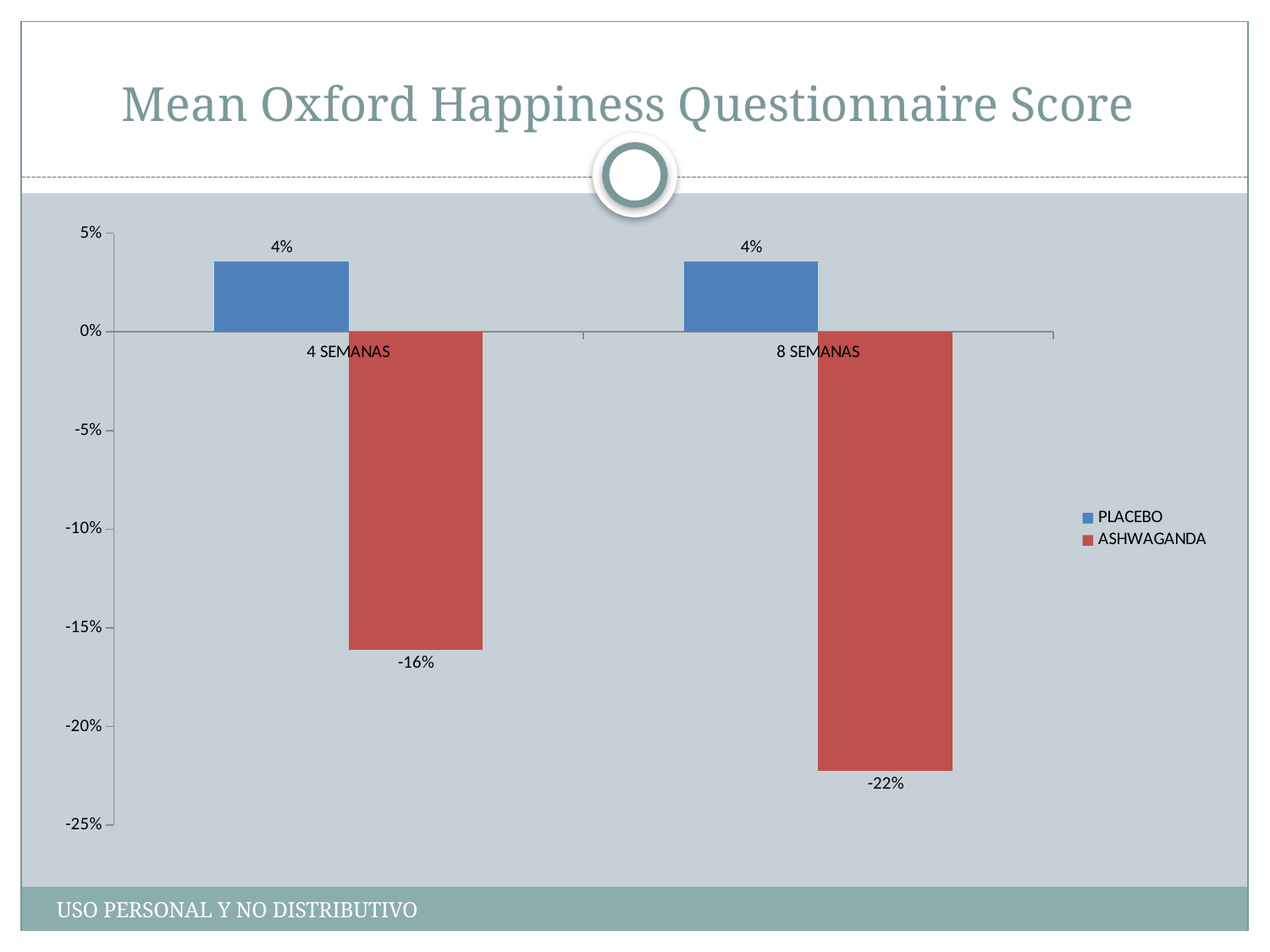
How many categories are shown on the x axis? 2 How many series does the legend list? 2 What kind of chart is shown on the slide? Bar chart At which category does ASHWAGANDA have its lowest value? 8 SEMANAS What is the value for ASHWAGANDA at 8 SEMANAS? -22% Which is larger at 8 SEMANAS, the PLACEBO value or the ASHWAGANDA value? PLACEBO What is the value for PLACEBO at 4 SEMANAS? 4% What is the difference between the ASHWAGANDA values at 4 SEMANAS and 8 SEMANAS? 6 percentage points What is the value for ASHWAGANDA at 4 SEMANAS? -16% What is the value for PLACEBO at 8 SEMANAS? 4% What is the difference between the PLACEBO and ASHWAGANDA values at 4 SEMANAS? 20 percentage points What is the title of the chart? Mean Oxford Happiness Questionnaire Score